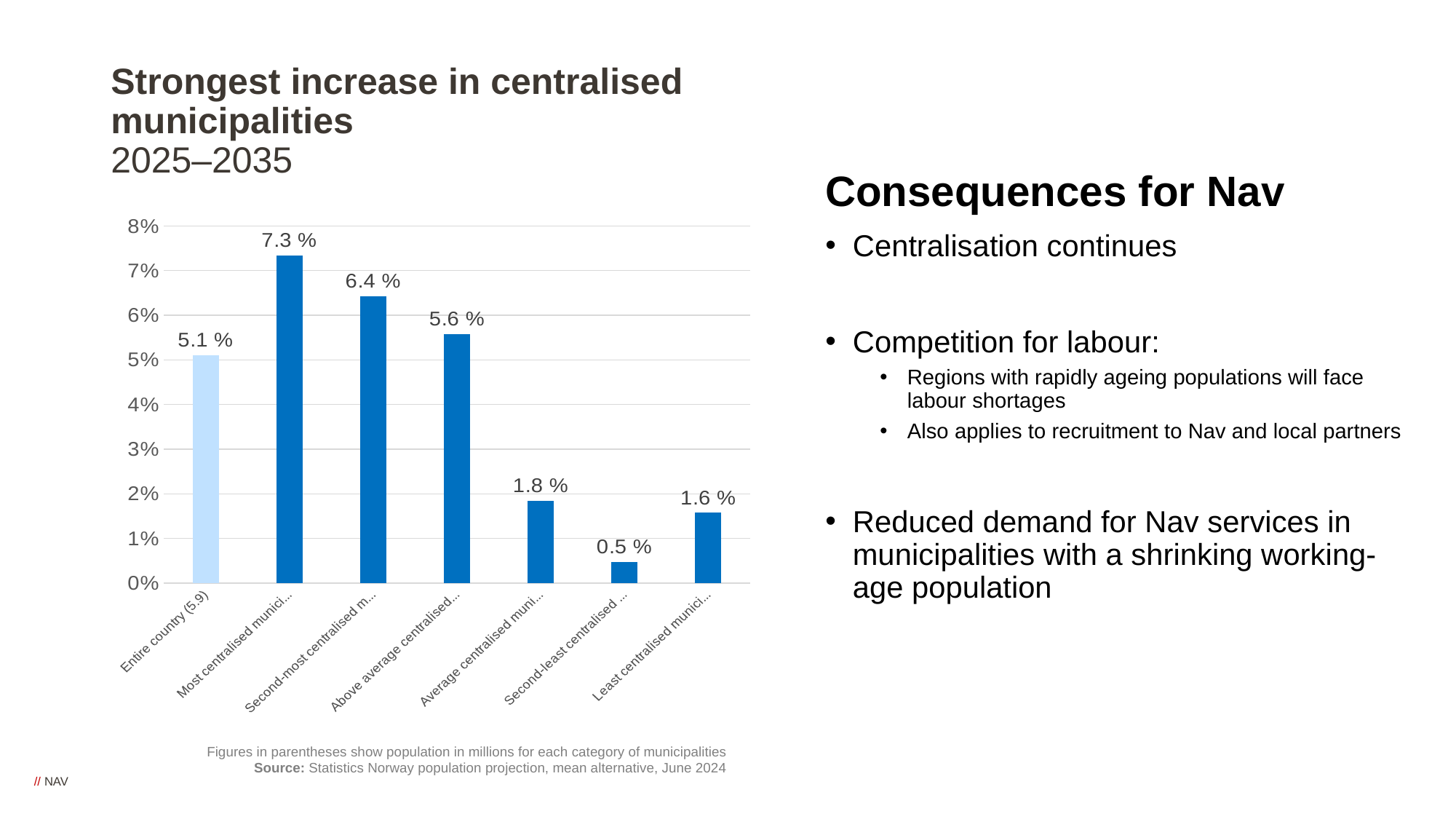
Which is larger: the value for Average centralised municipalities or for Least centralised municipalities? Average centralised municipalities What is the value for Entire country (5.9)? 5.1 % What is the value for the Second-least centralised municipalities category? 0.5 % What is the difference between the Most centralised municipalities value and the Entire country value? 2.2 % Which category has the highest value? Most centralised municipalities What is the difference between the Second-most centralised and Above average centralised values? 0.8 % Which bar is shown in a lighter blue colour than the others? Entire country (5.9) What kind of chart is shown on the slide? Bar chart Which category has the lowest value? Second-least centralised municipalities How many categories are shown on the x axis? 7 What is the value for the Above average centralised municipalities category? 5.6 % What is the value for the Most centralised municipalities category? 7.3 %